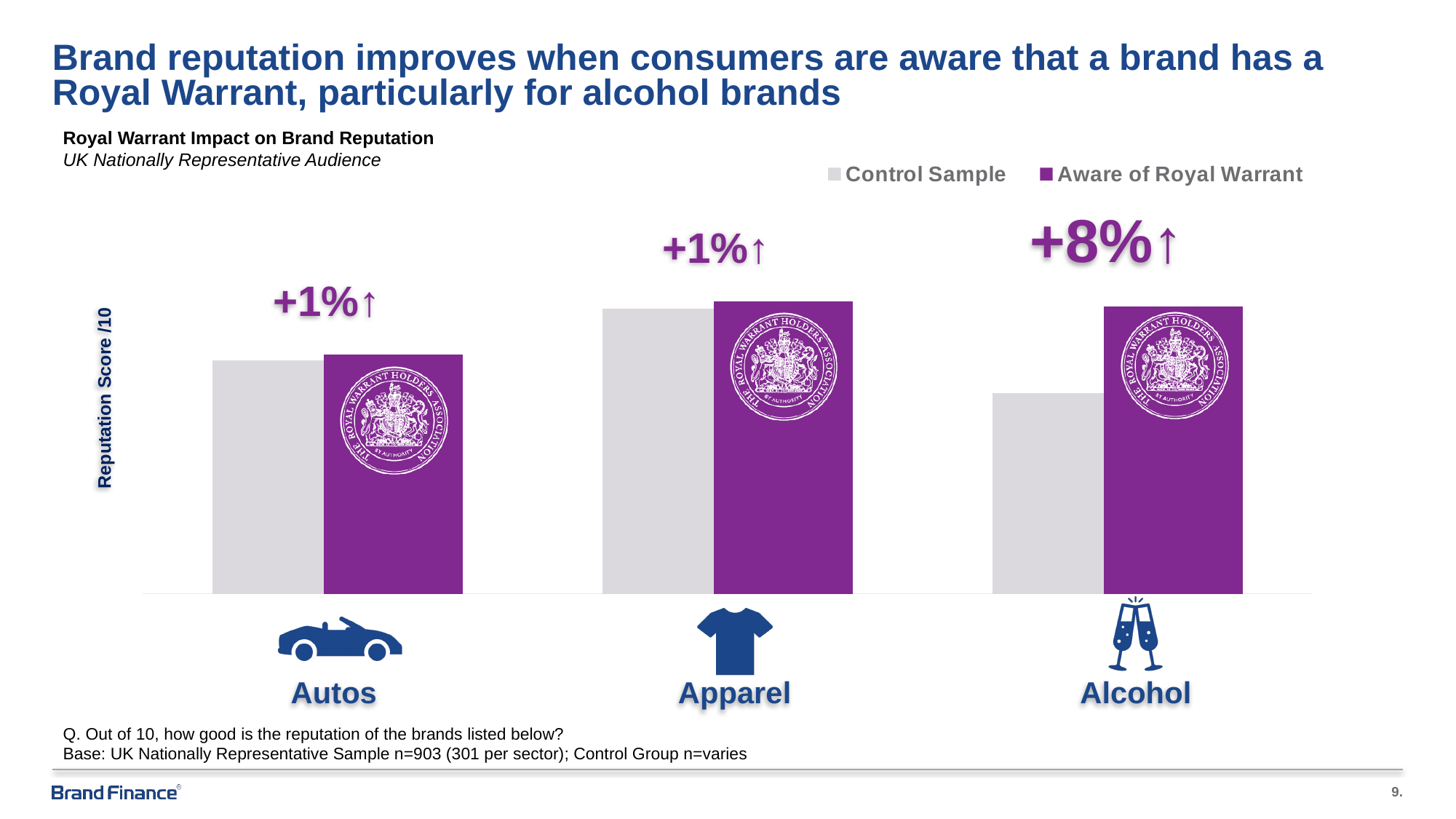
What kind of chart is shown on the slide? Bar chart What percentage uplift in reputation score is shown for Apparel? +1% What is the label on the vertical axis of the chart? Reputation Score /10 What percentage uplift in reputation score is shown for Alcohol? +8% How many sectors (categories) are shown on the x axis of the chart? 3 Which sector has the lowest Control Sample reputation score? Alcohol Which sector shows the largest percentage uplift from awareness of the Royal Warrant? Alcohol For Alcohol, which is larger: the Control Sample bar or the Aware of Royal Warrant bar? Aware of Royal Warrant How many series does the chart legend list? 2 What is the title of the chart? Royal Warrant Impact on Brand Reputation What percentage uplift in reputation score is shown for Autos? +1% Which sector has the highest Control Sample reputation score? Apparel